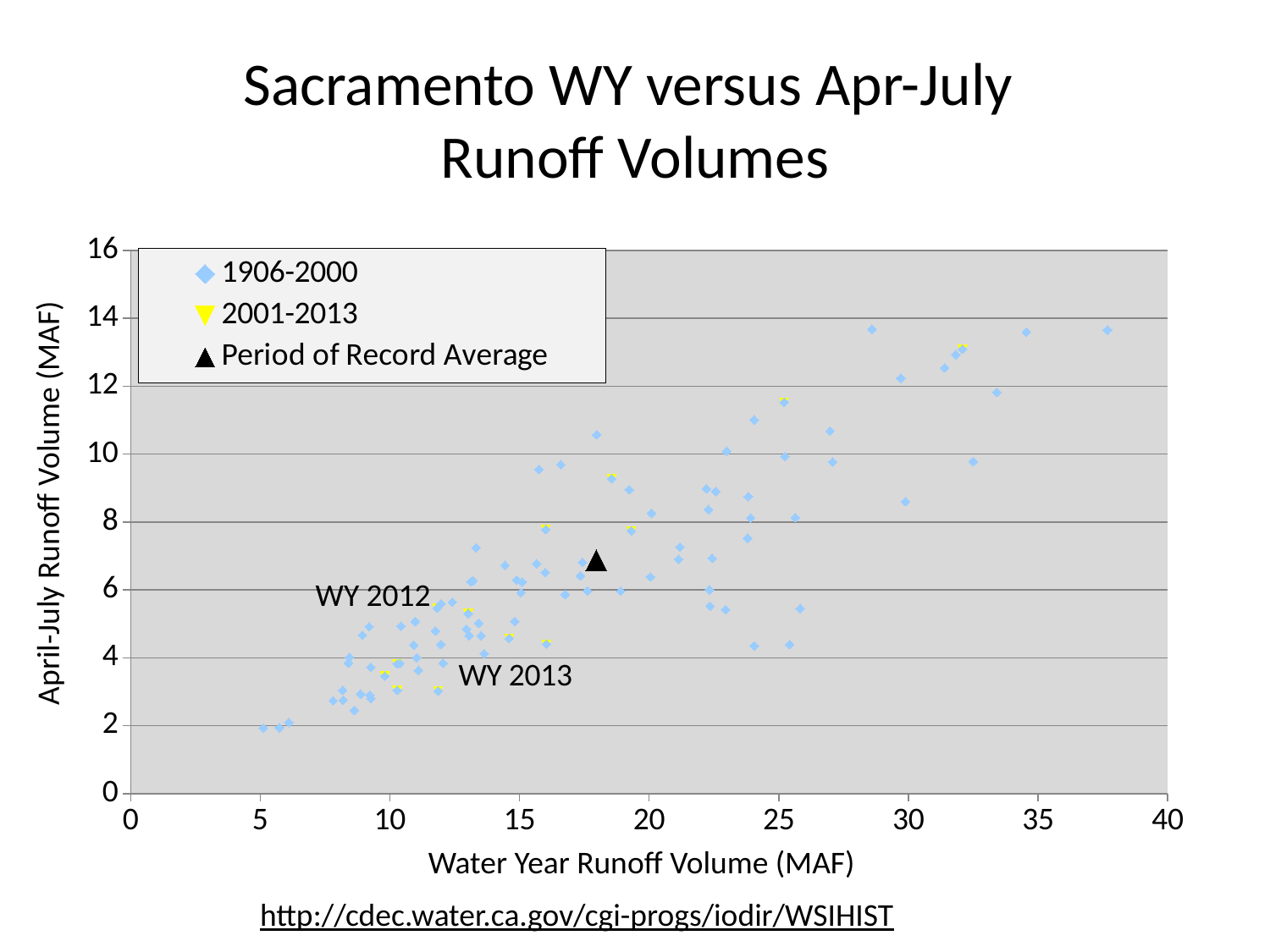
Is the April-July Runoff Volume of the Period of Record Average point greater or less than 8? less What kind of chart is shown on the slide? scatter chart What is the title of the x axis? Water Year Runoff Volume (MAF) Is the largest Water Year Runoff Volume plotted greater or less than 35? greater Do the April-July Runoff Volumes generally rise or fall as Water Year Runoff Volume increases? rise Is the Water Year Runoff Volume of the Period of Record Average point greater or less than 15? greater Which series does the black triangle marker represent? Period of Record Average How many series does the legend list? 3